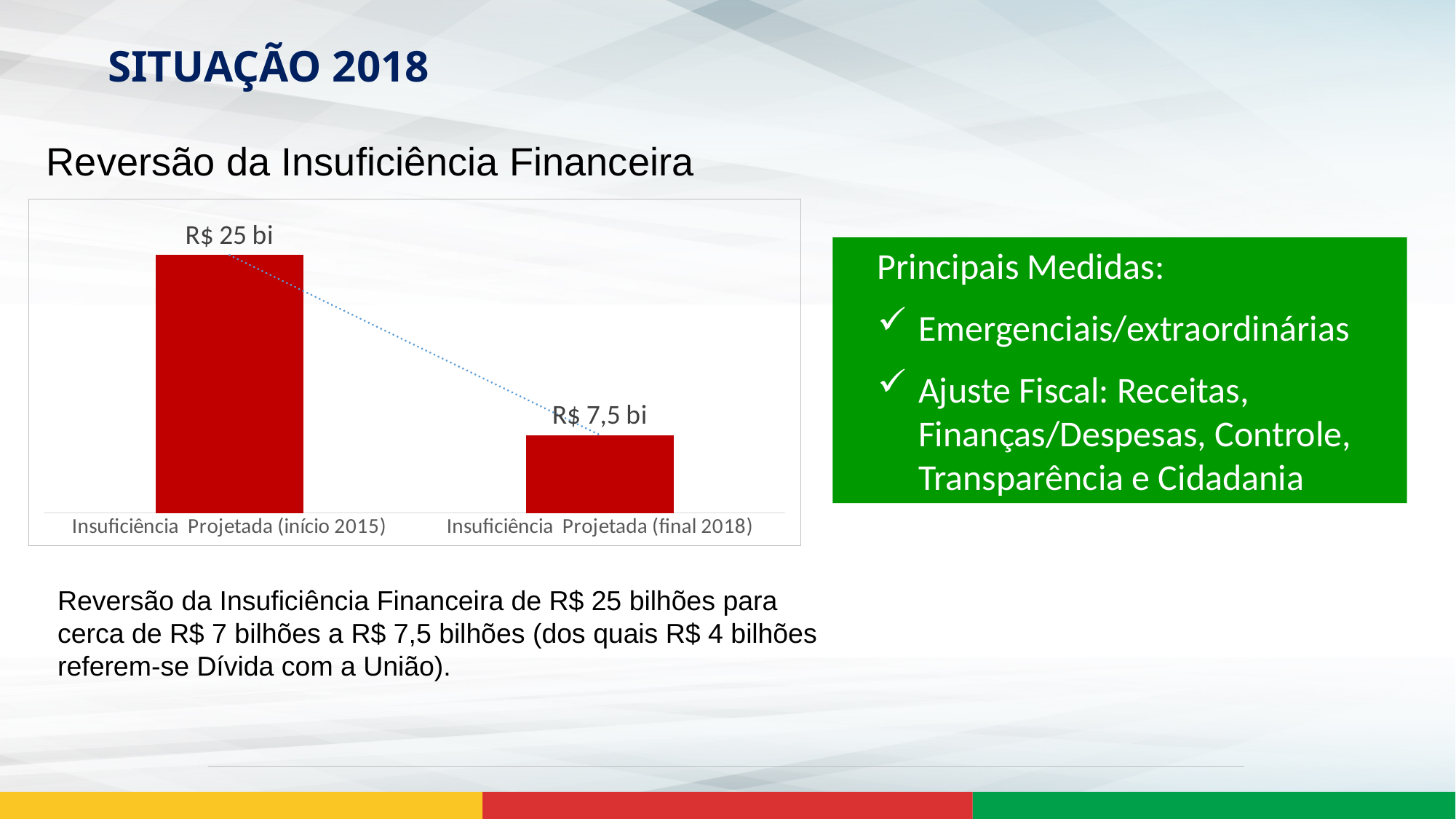
How many categories are shown in the chart? 2 Which category has the highest value? Insuficiência Projetada (início 2015) What colour are the bars in the chart? Red Which is larger: the value for Insuficiência Projetada (início 2015) or Insuficiência Projetada (final 2018)? Insuficiência Projetada (início 2015) What kind of chart is shown on the slide? Bar chart Which category has the lowest value? Insuficiência Projetada (final 2018) What is the heading shown above the chart? Reversão da Insuficiência Financeira Do the values rise or fall from the first category to the second? Fall What is the value for Insuficiência Projetada (final 2018)? R$ 7,5 bi What is the value for Insuficiência Projetada (início 2015)? R$ 25 bi What is the difference between the value for Insuficiência Projetada (início 2015) and Insuficiência Projetada (final 2018)? R$ 17,5 bi